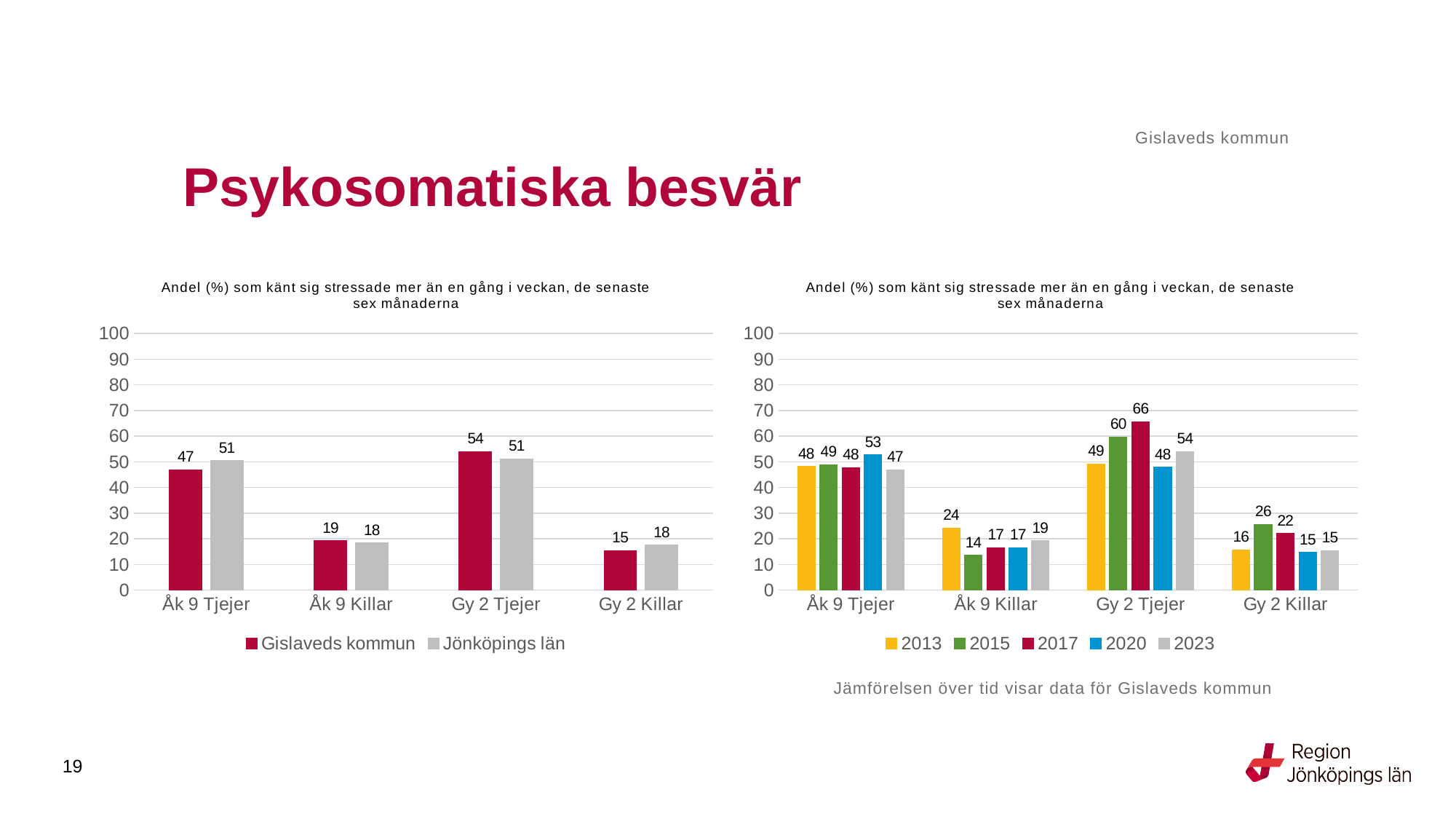
In the right chart, what is the difference between 2017 and 2023 for Gy 2 Tjejer? 12 In the left chart, which category has the lowest value for Gislaveds kommun? Gy 2 Killar In the left chart, what is the value for Gislaveds kommun for Gy 2 Tjejer? 54 In the left chart, how many series does the legend list? 2 In the right chart, how many series does the legend list? 5 In the left chart, what is the difference between Jönköpings län and Gislaveds kommun for Åk 9 Tjejer? 4 In the left chart, what is the value for Jönköpings län for Åk 9 Killar? 18 In the right chart, which year has the highest value for Åk 9 Tjejer? 2020 In the right chart, what is the value for 2017 for Gy 2 Tjejer? 66 In the right chart, which is larger for Gy 2 Killar: 2015 or 2023? 2015 What type of chart is the right chart? Bar chart In the right chart, what is the value for 2013 for Åk 9 Killar? 24